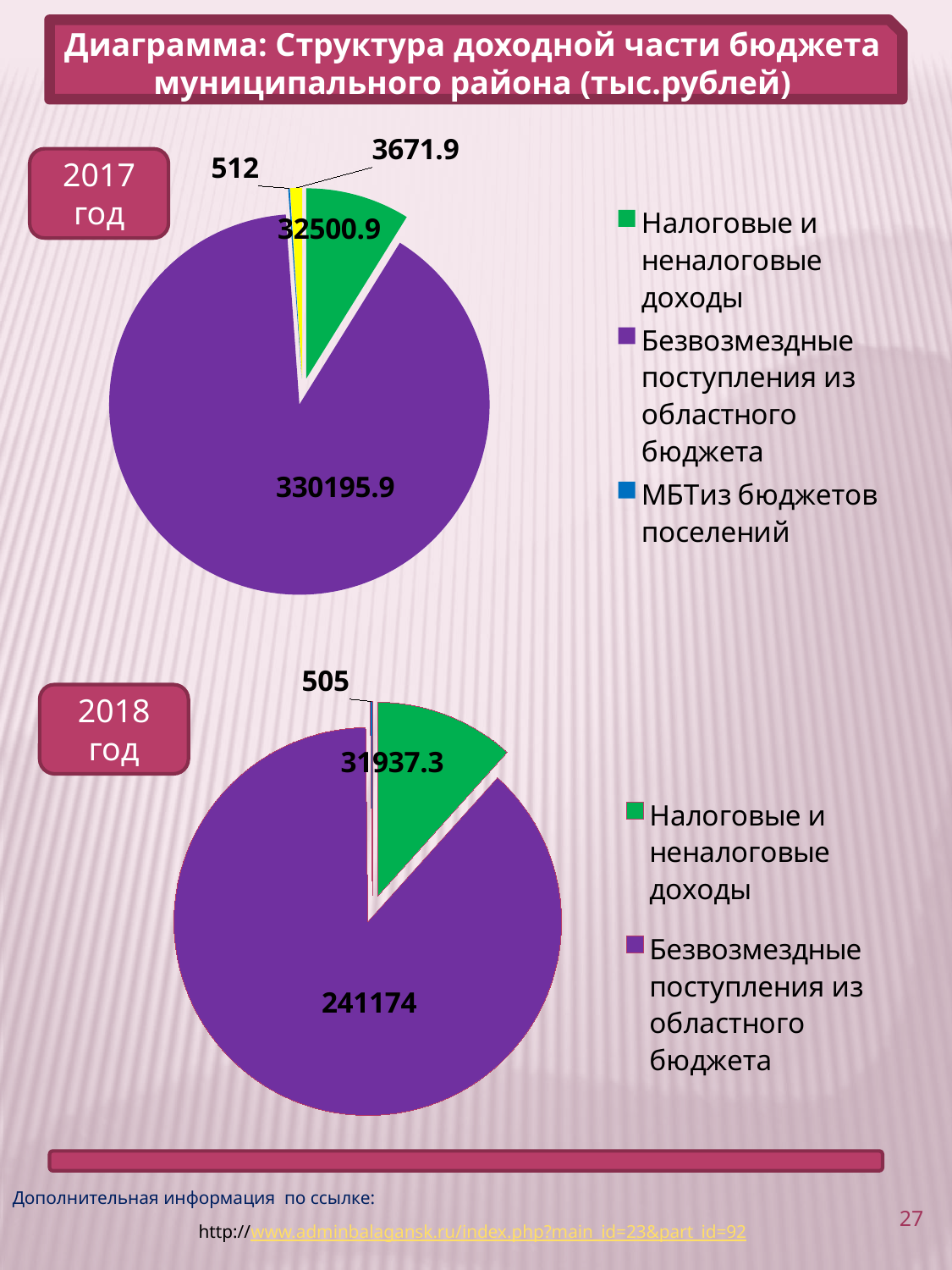
In the 2017 год chart, what is the value for Безвозмездные поступления из областного бюджета? 330195.9 In the 2017 год chart, what is the value for МБТиз бюджетов поселений? 512 In the 2017 год chart, which category has the largest slice? Безвозмездные поступления из областного бюджета What type of chart is used for the 2017 год data? Pie chart In the 2017 год chart, what is the value for Налоговые и неналоговые доходы? 32500.9 In the 2018 год chart, what is the value for Безвозмездные поступления из областного бюджета? 241174 In the 2018 год chart, what is the difference between Безвозмездные поступления из областного бюджета and Налоговые и неналоговые доходы? 209236.7 In the 2017 год chart, which legend category has the smallest value? МБТиз бюджетов поселений Which is larger: Налоговые и неналоговые доходы in the 2017 год chart or in the 2018 год chart? 2017 год In the 2017 год chart, what is the difference between Безвозмездные поступления из областного бюджета and Налоговые и неналоговые доходы? 297695 In the 2018 год chart, what is the value for Налоговые и неналоговые доходы? 31937.3 How many entries does the legend of the 2018 год chart list? 2